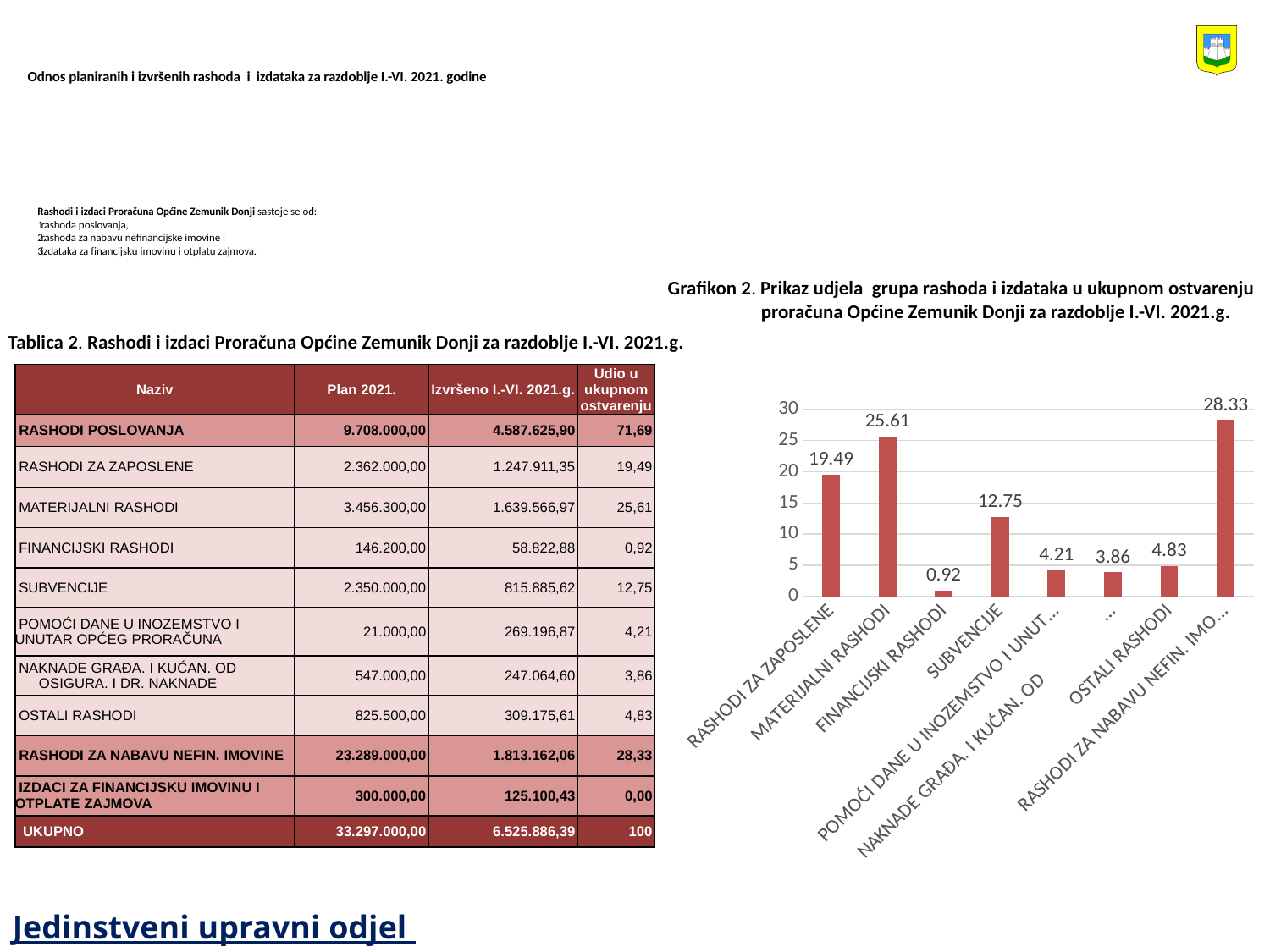
What type of chart is shown on the slide? bar chart What is the highest value labelled on the chart's vertical axis? 30 In the chart, what is the value shown for RASHODI ZA ZAPOSLENE? 19.49 In the chart, what is the value shown for OSTALI RASHODI? 4.83 Which category has the highest bar in the chart? RASHODI ZA NABAVU NEFIN. IMOVINE In the chart, which is larger: the value for SUBVENCIJE or the value for OSTALI RASHODI? SUBVENCIJE Which category has the lowest bar in the chart? FINANCIJSKI RASHODI In the chart, what is the difference between the values for MATERIJALNI RASHODI and RASHODI ZA ZAPOSLENE? 6.12 In the chart, what is the value shown for SUBVENCIJE? 12.75 In the chart, what is the value shown for MATERIJALNI RASHODI? 25.61 In the chart, is the value for RASHODI ZA ZAPOSLENE greater or less than 15? greater How many bars are plotted in the chart? 8